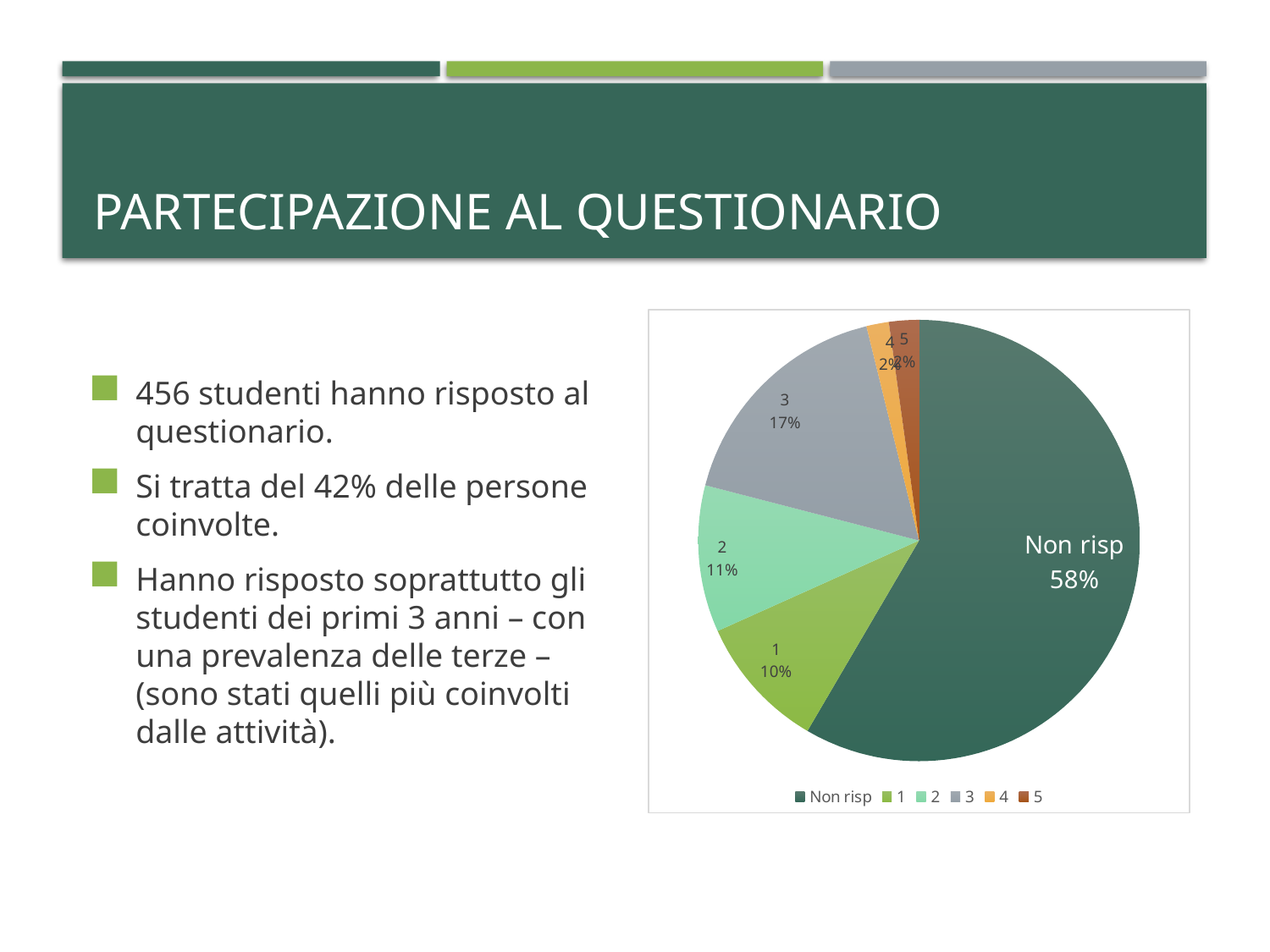
What percentage is shown for category 1? 10% Which category has the largest slice of the pie? Non risp What share of the pie does the "Non risp" slice represent? 58% How many entries does the legend list? 6 Which is larger, the slice for category 3 or the slice for category 2? 3 How many slices does the pie chart have? 6 What percentage is shown for category 2? 11% What is the difference in percentage points between category 2 and category 1? 1 What percentage is shown for category 3? 17% What type of chart is shown on the slide? Pie chart What is the first entry in the chart legend? Non risp What is the difference in percentage points between the "Non risp" slice and the slice for category 3? 41